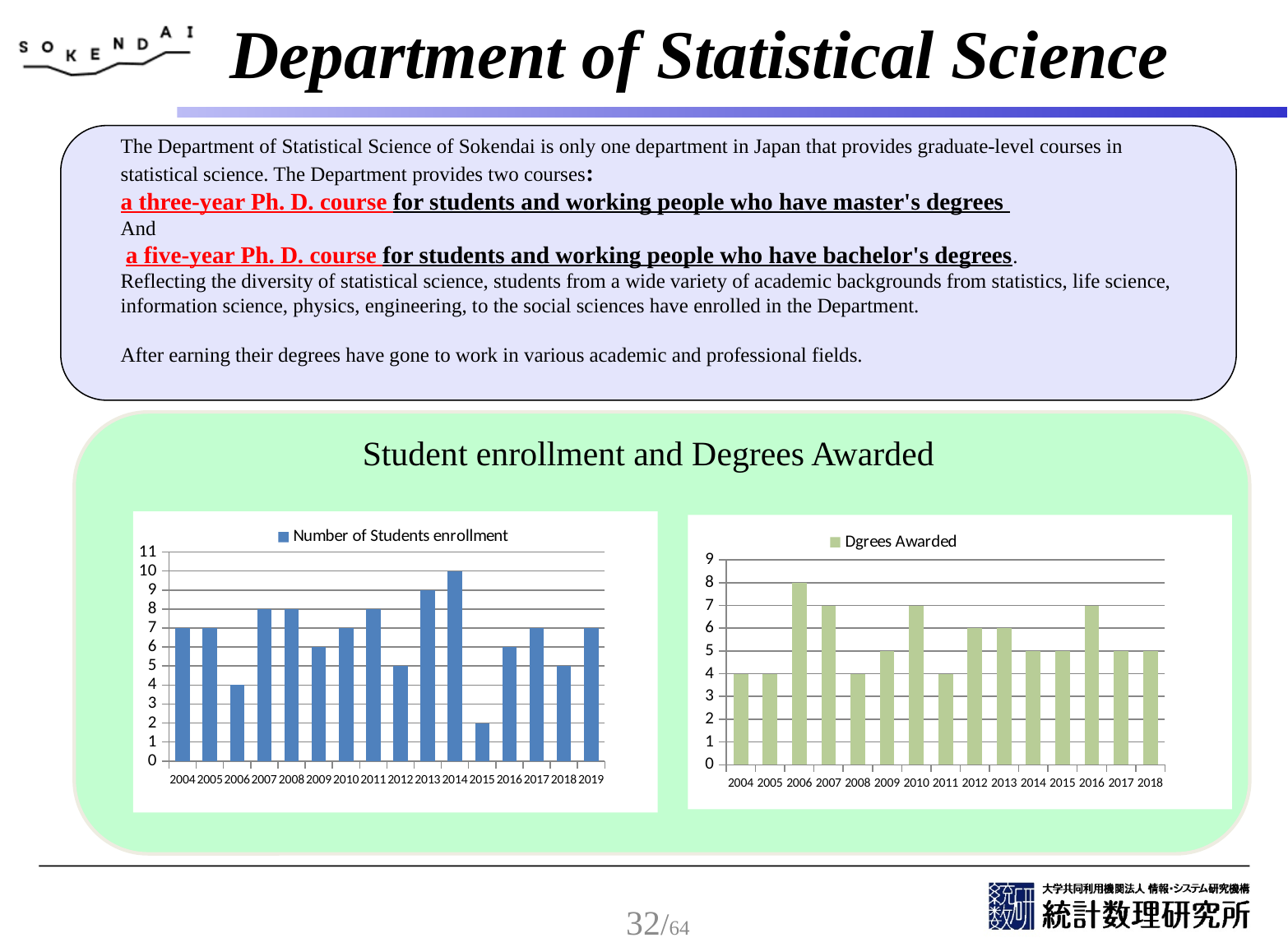
In the Dgrees Awarded chart, which is larger, the value for 2007 or the value for 2008? 2007 In the Number of Students enrollment chart, which year has the lowest enrollment? 2015 How many series does the legend of the Dgrees Awarded chart list? 1 In the Dgrees Awarded chart, what is the value for 2006? 8 What type of chart is the Number of Students enrollment chart? bar chart In the Number of Students enrollment chart, which year has the highest enrollment? 2014 In the Number of Students enrollment chart, how many years are shown on the x axis? 16 In the Dgrees Awarded chart, which year has the highest number of degrees awarded? 2006 In the Dgrees Awarded chart, how many years are shown on the x axis? 15 In the Number of Students enrollment chart, what is the enrollment value for 2015? 2 In the Number of Students enrollment chart, what is the enrollment value for 2014? 10 In the Number of Students enrollment chart, what is the difference between the 2014 and 2015 values? 8